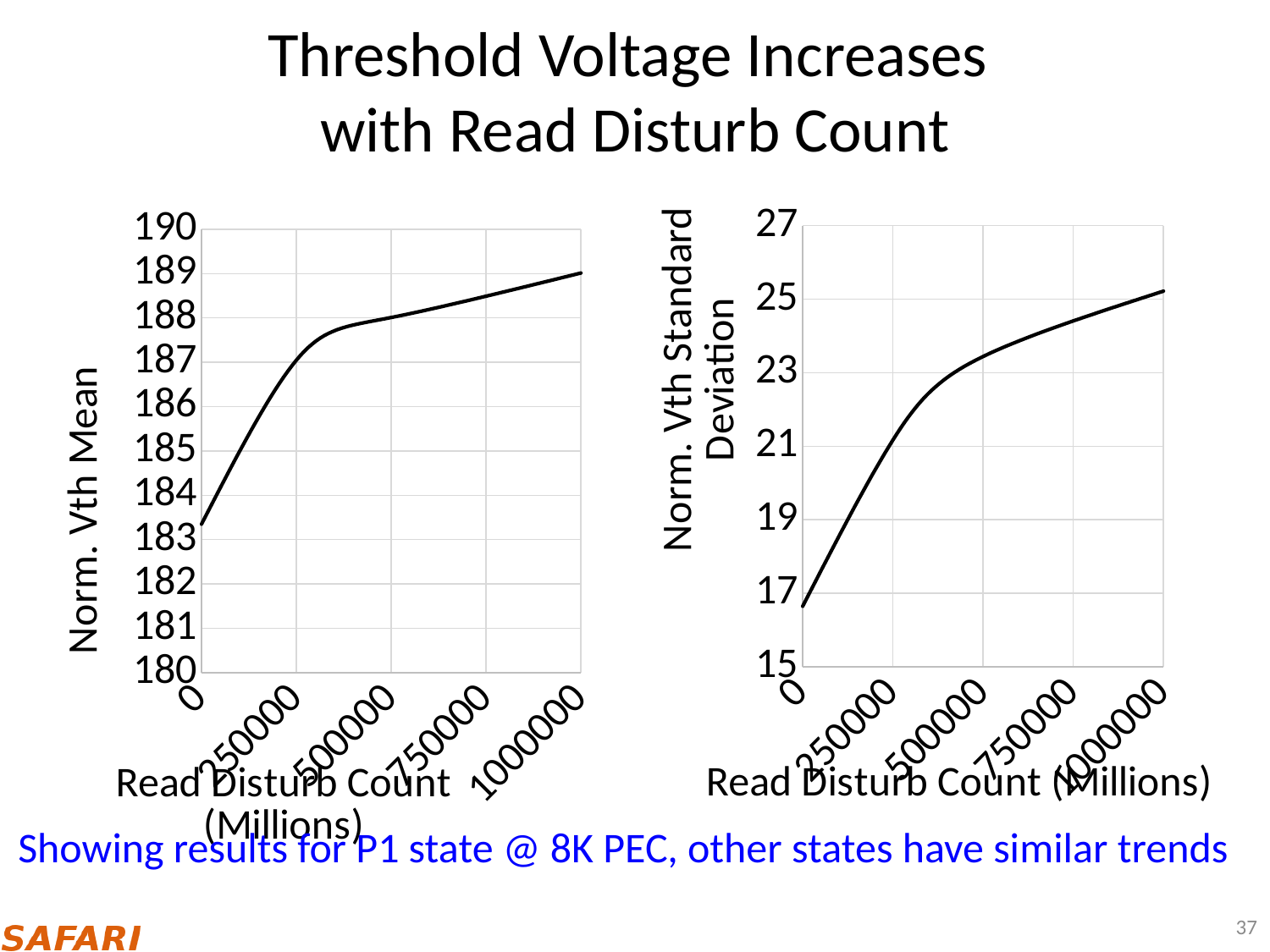
In the left chart, is the Norm. Vth Mean at a Read Disturb Count of 0 greater or less than 184? less In the right chart, is the Norm. Vth Standard Deviation at a Read Disturb Count of 0 greater or less than 17? less In the left chart, is the Norm. Vth Mean at a Read Disturb Count of 1000000 greater or less than 188? greater In the right chart, which Read Disturb Count has the larger Norm. Vth Standard Deviation, 250000 or 750000? 750000 In the right chart, does Norm. Vth Standard Deviation rise or fall as Read Disturb Count increases? rise What kind of chart is the right chart (Norm. Vth Standard Deviation)? line chart What is the y-axis label of the left chart? Norm. Vth Mean What kind of chart is the left chart (Norm. Vth Mean)? line chart What is the x-axis label of the right chart? Read Disturb Count (Millions) In the left chart, which Read Disturb Count has the larger Norm. Vth Mean, 250000 or 750000? 750000 In the left chart, does Norm. Vth Mean rise or fall as Read Disturb Count increases? rise